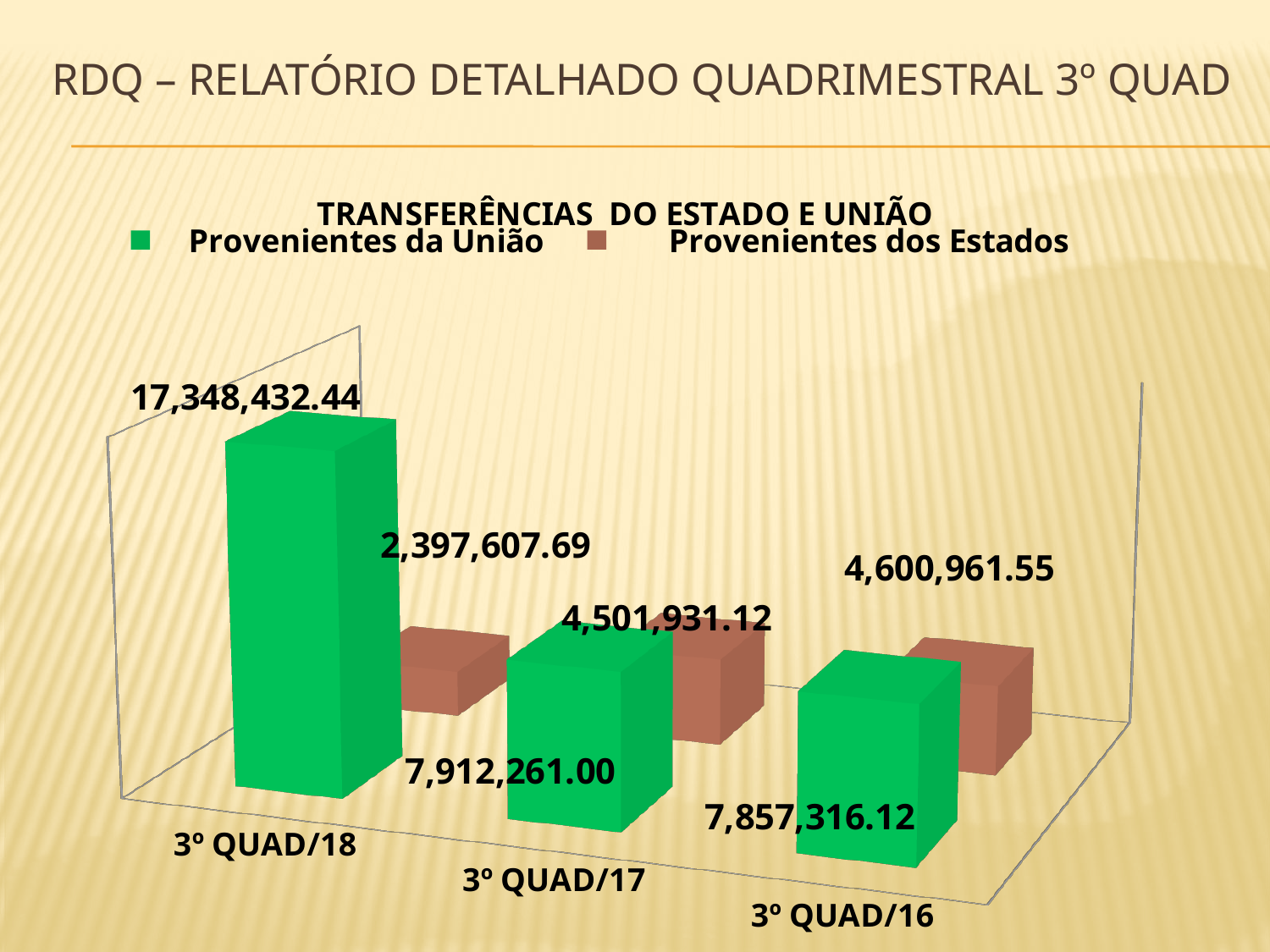
How many periods are shown on the x axis of the chart? 3 In 3º QUAD/17, which is larger: Provenientes da União or Provenientes dos Estados? Provenientes da União What is the value for Provenientes da União in 3º QUAD/16? 7,857,316.12 What is the difference between Provenientes da União and Provenientes dos Estados in 3º QUAD/18? 14,950,824.75 What is the title of the chart? TRANSFERÊNCIAS DO ESTADO E UNIÃO What is the value for Provenientes dos Estados in 3º QUAD/18? 2,397,607.69 In which period is the value for Provenientes dos Estados lowest? 3º QUAD/18 What is the difference between Provenientes dos Estados in 3º QUAD/16 and in 3º QUAD/17? 99,030.43 What is the value for Provenientes da União in 3º QUAD/18? 17,348,432.44 What is the value for Provenientes dos Estados in 3º QUAD/17? 4,501,931.12 How many series does the legend list? 2 In which period is the value for Provenientes da União highest? 3º QUAD/18